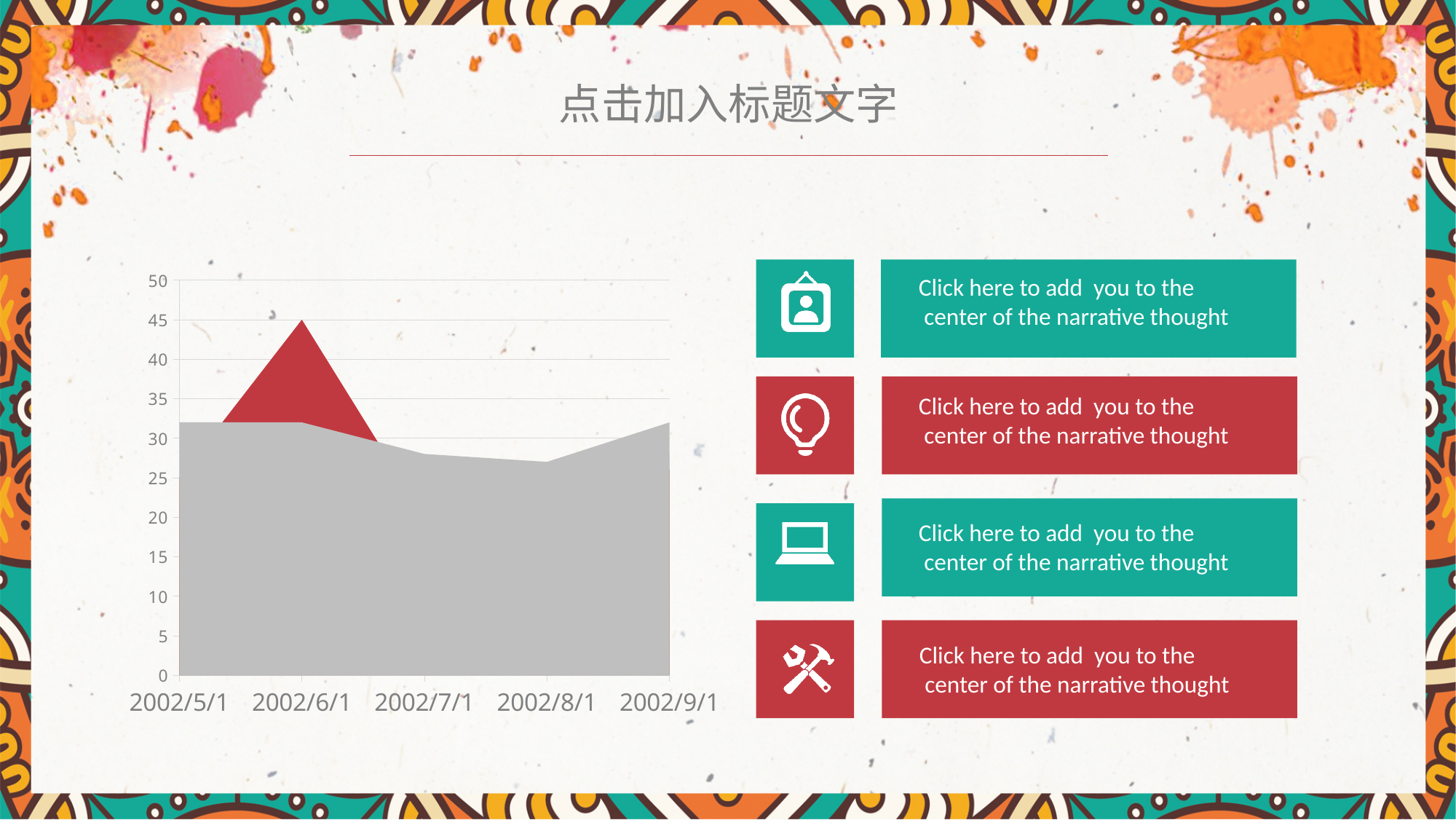
Is the value of the red series at 2002/6/1 greater or less than 40? greater What is the first date label on the x axis of the chart? 2002/5/1 At which date does the red series reach its highest value? 2002/6/1 Does the gray series rise or fall between 2002/6/1 and 2002/8/1? fall At 2002/6/1, which series has the larger value, the red series or the gray series? red series Is the value of the gray series at 2002/5/1 greater or less than 30? greater What is the highest value shown on the y axis of the chart? 50 How many dates are labelled on the x axis of the chart? 5 Is the value of the gray series at 2002/8/1 greater or less than 30? less What two colours are used for the plotted areas in the chart? red and gray What is the last date label on the x axis of the chart? 2002/9/1 What kind of chart is shown on the slide? area chart